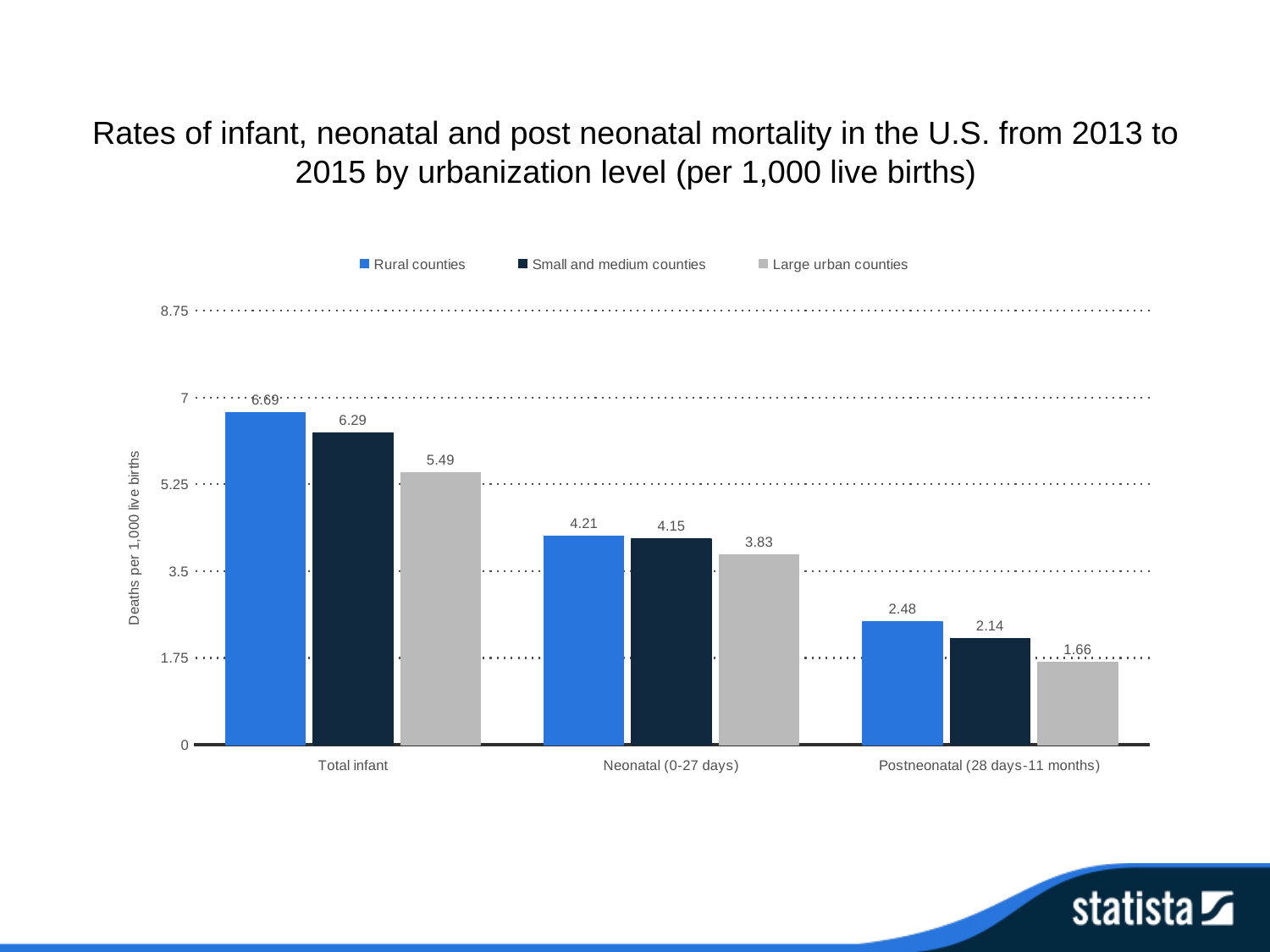
What kind of chart is shown on the slide? Bar chart Which series has the lowest value in the Postneonatal (28 days-11 months) category? Large urban counties What is the value for small and medium counties in the Postneonatal (28 days-11 months) category? 2.14 How many categories are shown on the x axis? 3 Which is larger in the Neonatal (0-27 days) category: rural counties or large urban counties? Rural counties What is the label of the y axis? Deaths per 1,000 live births What is the infant mortality rate for rural counties in the Total infant category? 6.69 Is the value for small and medium counties in the Total infant category greater or less than 7? less What is the difference between the rural counties and large urban counties values in the Total infant category? 1.2 Which category has the highest value for rural counties? Total infant How many series does the legend list? 3 What is the value for large urban counties in the Neonatal (0-27 days) category? 3.83